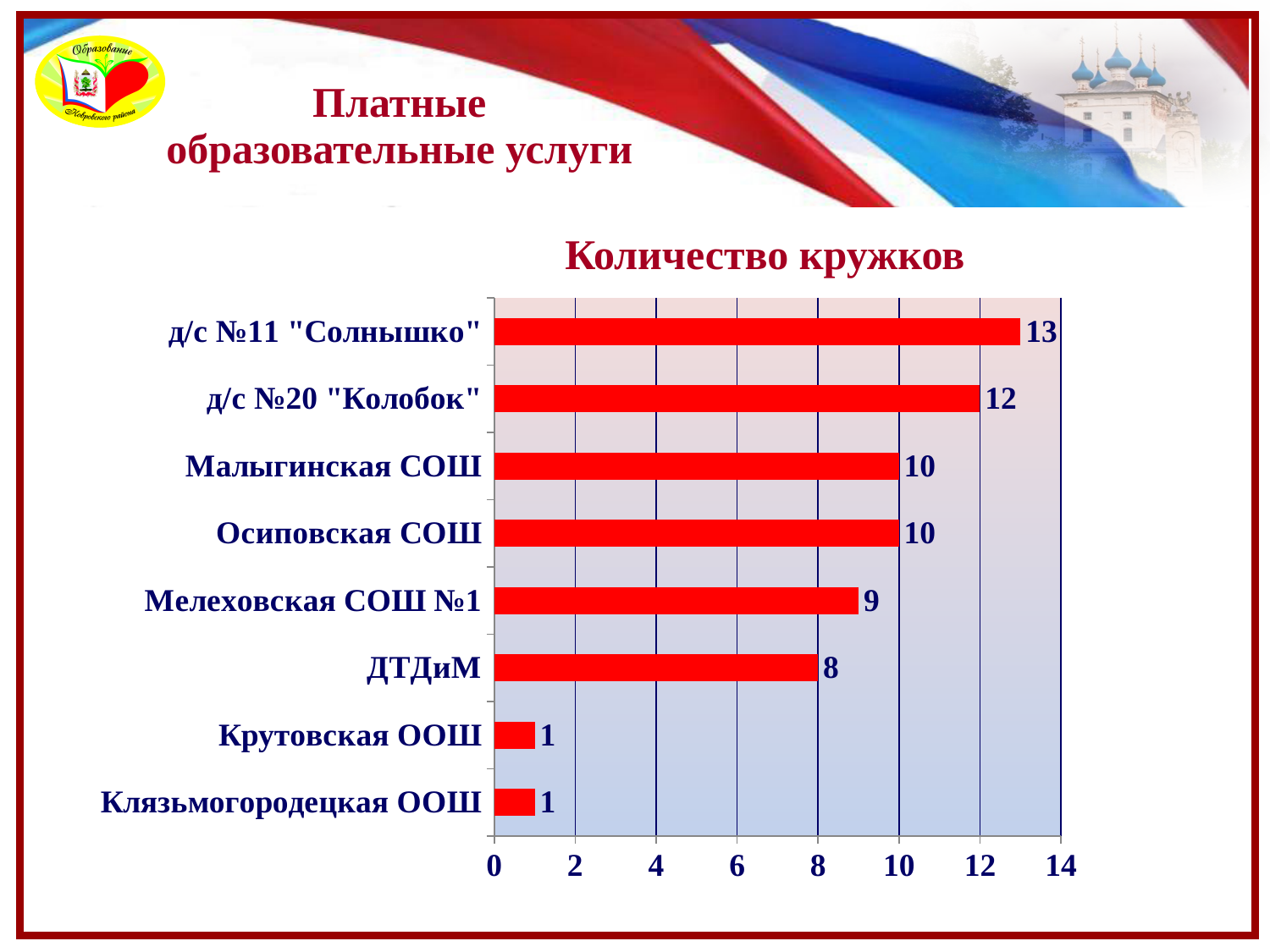
What is the value for Мелеховская СОШ №1? 9 Which is larger, the value for Малыгинская СОШ or the value for Мелеховская СОШ №1? Малыгинская СОШ What colour are the bars in the chart? red What is the difference between the values for д/с №20 "Колобок" and ДТДиМ? 4 What is the value for Крутовская ООШ? 1 What is the title of the chart? Количество кружков Which category has the highest value? д/с №11 "Солнышко" What kind of chart is shown on the slide? bar chart What is the value for ДТДиМ? 8 Is the value for д/с №20 "Колобок" greater or less than 10? greater How many categories are shown in the chart? 8 What is the value for д/с №11 "Солнышко"? 13